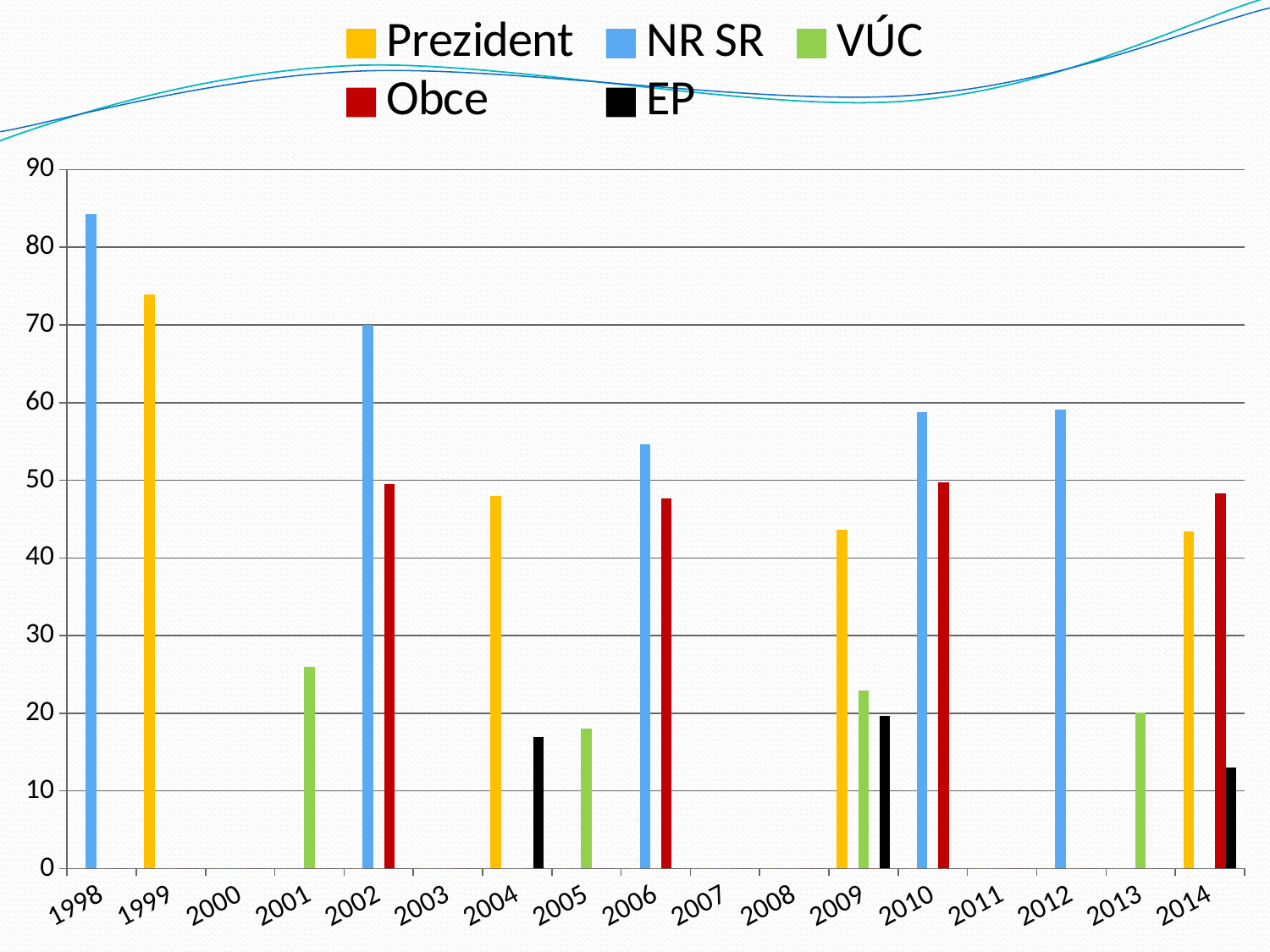
Is the Prezident value for 1999 greater or less than 70? greater Which colour represents the Obce series in the legend? red Which series has the tallest bar in the chart? NR SR Which year has the tallest bar in the chart? 1998 Which is larger, the VÚC value for 2001 or the VÚC value for 2005? 2001 Which is larger, the NR SR value for 2002 or the NR SR value for 2006? 2002 What kind of chart is shown on the slide? bar chart Is the EP value for 2014 greater or less than 20? less Is the NR SR value for 1998 greater or less than 80? greater How many series does the legend list? 5 How many years are shown on the x axis? 17